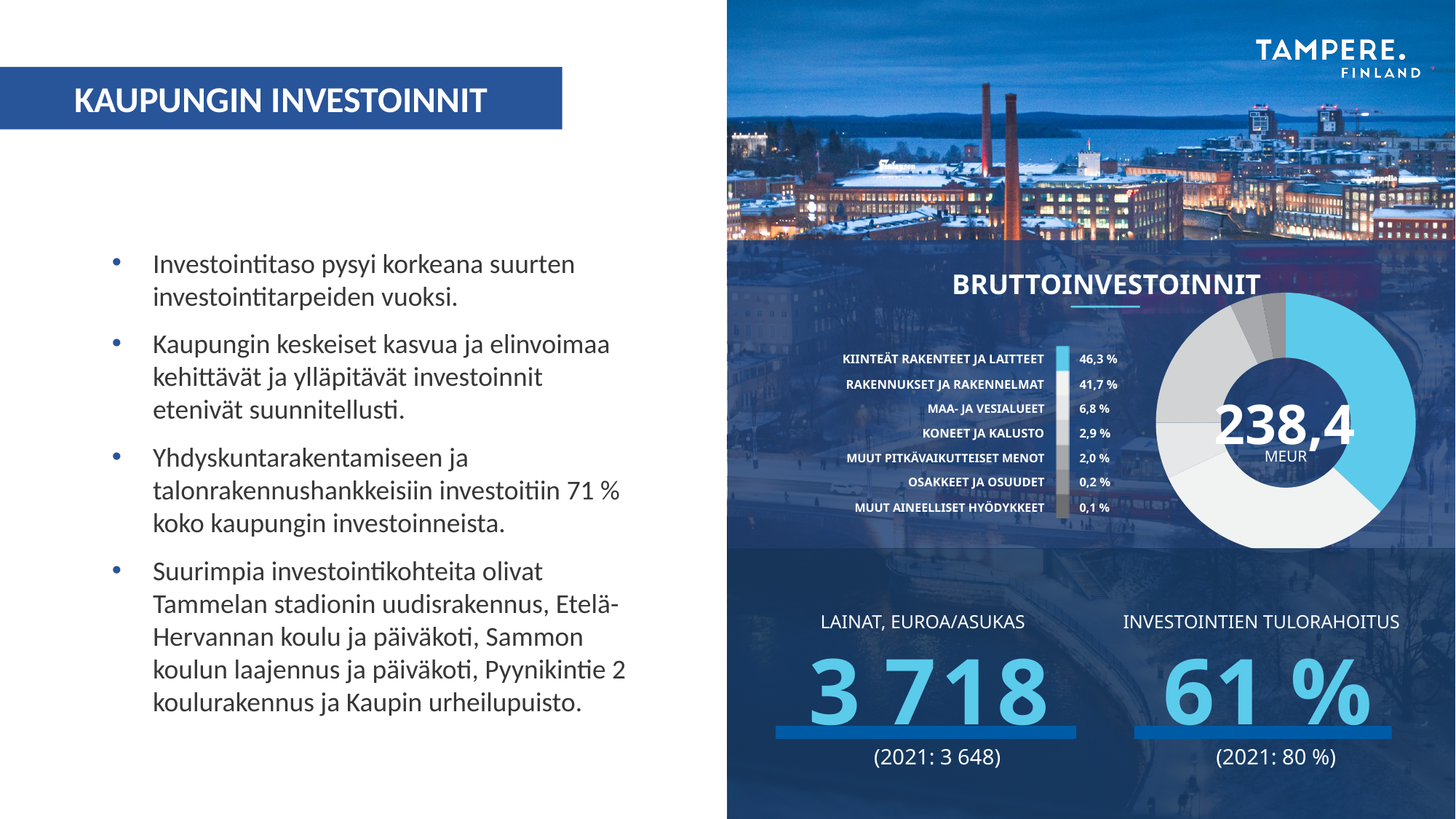
Which category has the smallest share in the BRUTTOINVESTOINNIT chart? MUUT AINEELLISET HYÖDYKKEET In the BRUTTOINVESTOINNIT chart, which is larger: MAA- JA VESIALUEET or KONEET JA KALUSTO? MAA- JA VESIALUEET In the BRUTTOINVESTOINNIT chart, what share is shown for MAA- JA VESIALUEET? 6,8 % Which category has the largest share in the BRUTTOINVESTOINNIT chart? KIINTEÄT RAKENTEET JA LAITTEET In the BRUTTOINVESTOINNIT chart, what share is shown for KONEET JA KALUSTO? 2,9 % What total value is shown in the centre of the BRUTTOINVESTOINNIT donut chart? 238,4 MEUR What kind of chart is shown under the title BRUTTOINVESTOINNIT? Donut (pie) chart In the BRUTTOINVESTOINNIT chart, what share is shown for RAKENNUKSET JA RAKENNELMAT? 41,7 % In the BRUTTOINVESTOINNIT chart, what is the difference in percentage points between KIINTEÄT RAKENTEET JA LAITTEET and RAKENNUKSET JA RAKENNELMAT? 4,6 percentage points In the BRUTTOINVESTOINNIT chart, what share is shown for KIINTEÄT RAKENTEET JA LAITTEET? 46,3 % How many categories are listed in the BRUTTOINVESTOINNIT chart? 7 In the BRUTTOINVESTOINNIT chart, what share is shown for OSAKKEET JA OSUUDET? 0,2 %